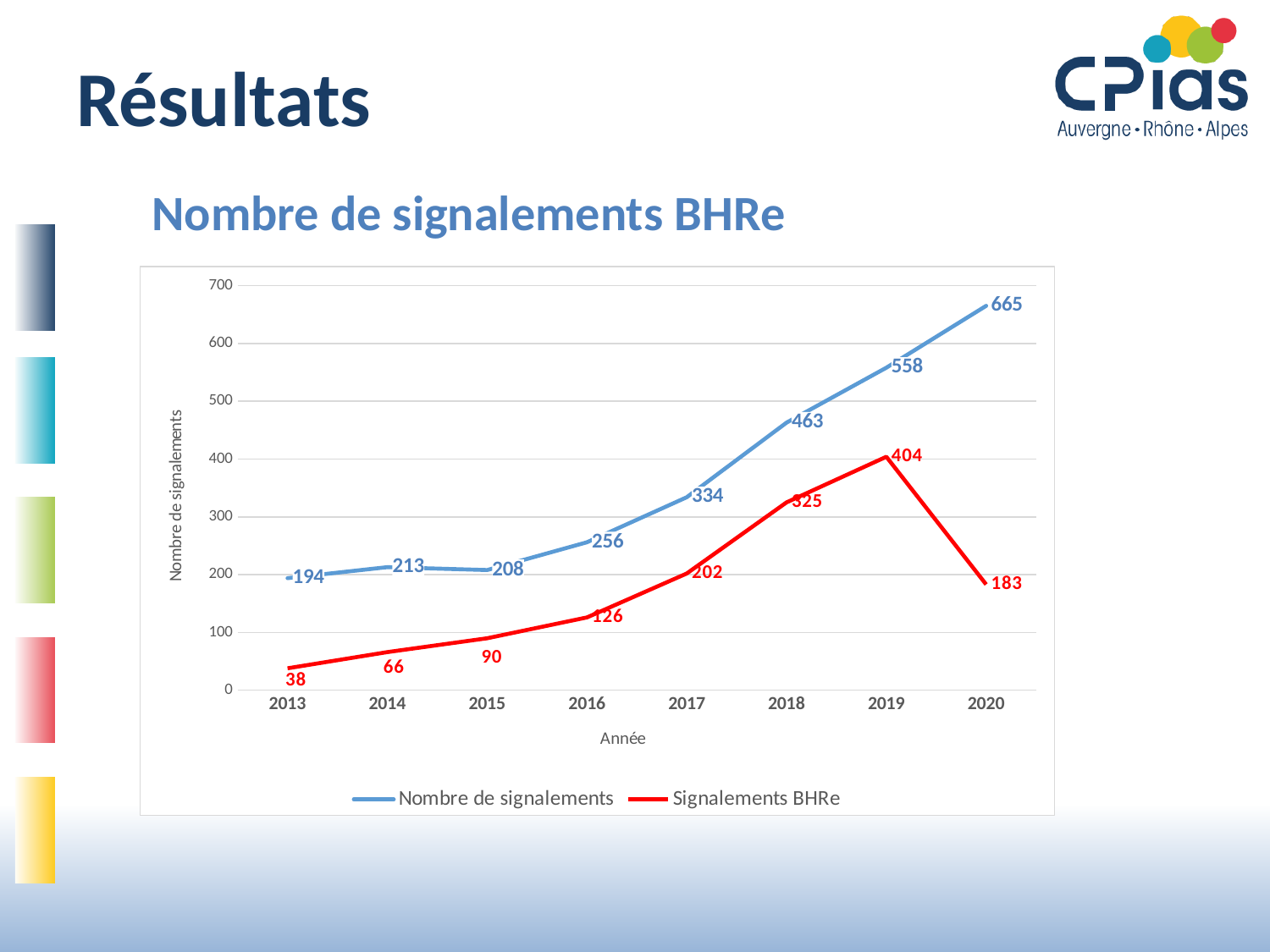
How many series does the legend list? 2 Does Nombre de signalements rise or fall from 2013 to 2020? Rise What is the value of Signalements BHRe in 2013? 38 What kind of chart is shown? Line chart What is the value of Signalements BHRe in 2019? 404 What is the value of Nombre de signalements in 2020? 665 What is the difference between Nombre de signalements and Signalements BHRe in 2020? 482 What is the label of the y axis? Nombre de signalements In which year is Nombre de signalements lowest? 2013 How many years are shown on the x axis? 8 Which is larger in 2018: Nombre de signalements or Signalements BHRe? Nombre de signalements In which year is Signalements BHRe highest? 2019